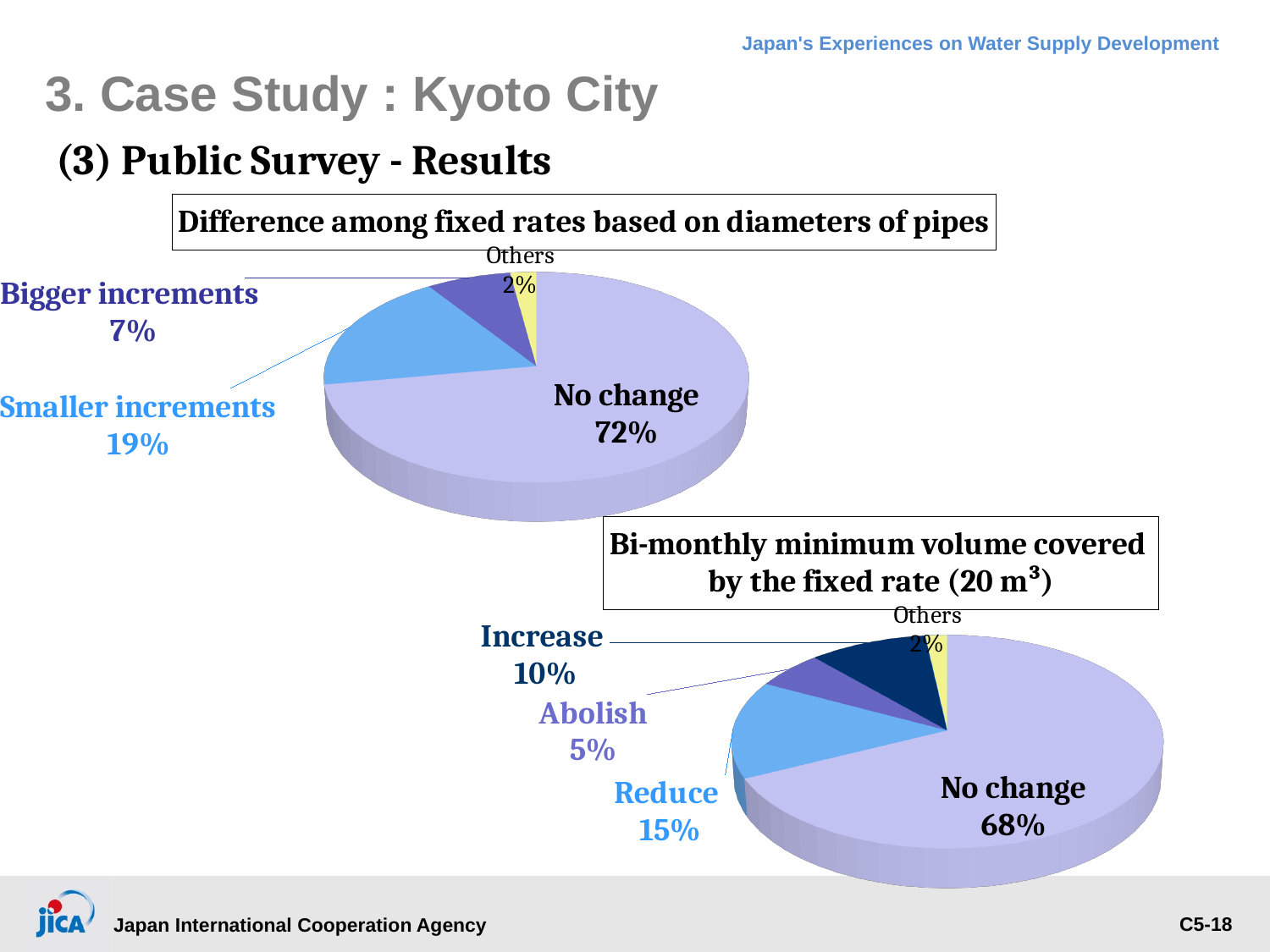
In the 'Difference among fixed rates based on diameters of pipes' chart, which category has the smallest share? Others In the 'Difference among fixed rates based on diameters of pipes' chart, what share chose 'Smaller increments'? 19% What type of chart is used for both charts on the slide? Pie chart In the 'Bi-monthly minimum volume covered by the fixed rate (20 m³)' chart, what share chose 'Reduce'? 15% In the 'Difference among fixed rates based on diameters of pipes' chart, which category has the largest share? No change In the 'Bi-monthly minimum volume covered by the fixed rate (20 m³)' chart, which is larger, 'Increase' or 'Abolish'? Increase In the 'Difference among fixed rates based on diameters of pipes' chart, what share of respondents chose 'No change'? 72% In the 'Bi-monthly minimum volume covered by the fixed rate (20 m³)' chart, what share chose 'No change'? 68% In the 'Bi-monthly minimum volume covered by the fixed rate (20 m³)' chart, how many categories are shown? 5 In the 'Difference among fixed rates based on diameters of pipes' chart, how many categories are shown? 4 In the 'Difference among fixed rates based on diameters of pipes' chart, what share chose 'Bigger increments'? 7% In the 'Difference among fixed rates based on diameters of pipes' chart, what is the difference between 'Smaller increments' and 'Bigger increments'? 12%